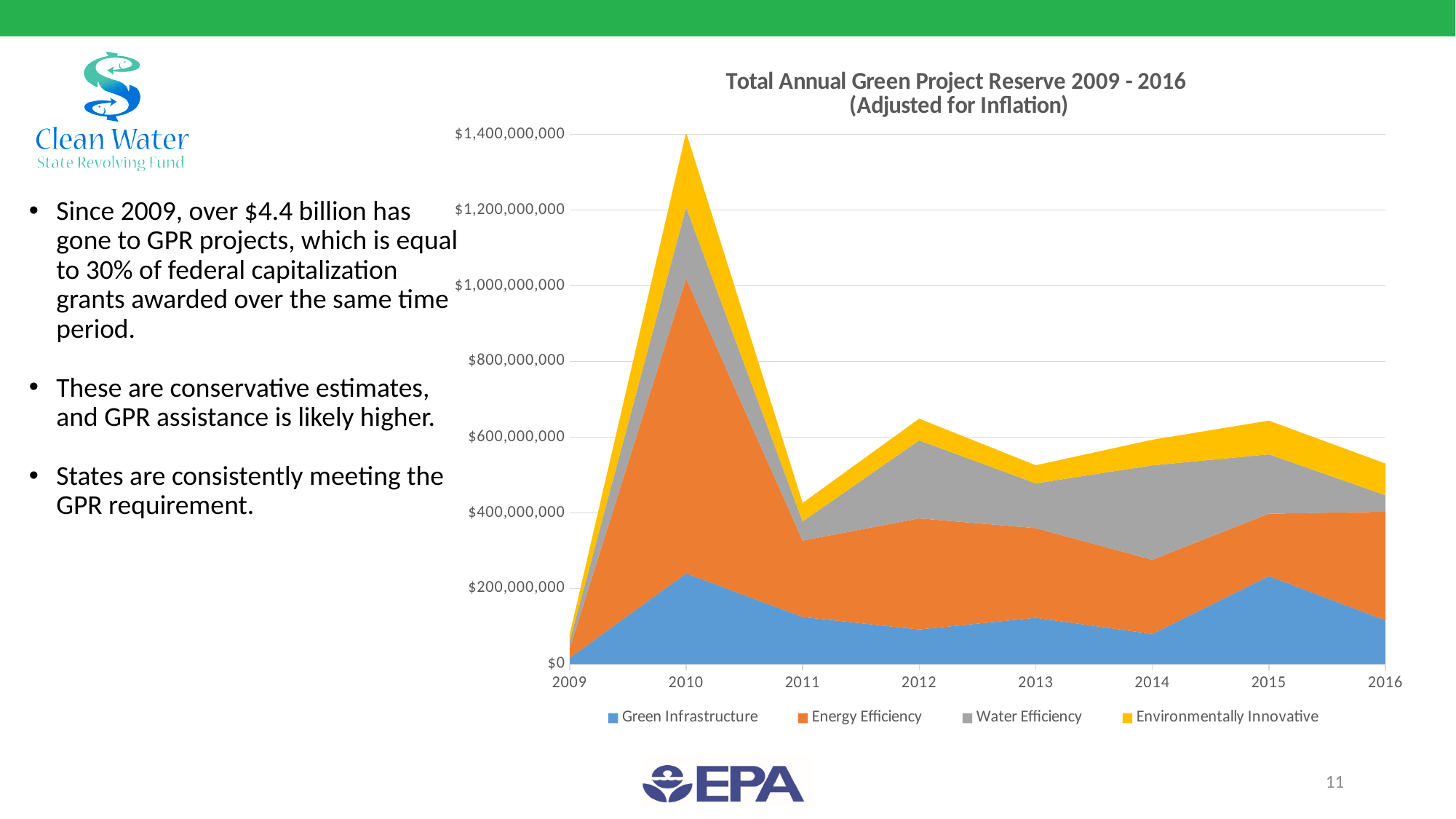
In which year is the total annual Green Project Reserve highest? 2010 How many series does the chart's legend list? 4 Is the total value for 2011 greater or less than $600,000,000? less In which year is the total annual Green Project Reserve lowest? 2009 Does the total value rise or fall from 2010 to 2011? Fall Which year has the larger total, 2010 or 2012? 2010 Which series is shown in yellow in the chart's legend? Environmentally Innovative What is the title of the chart? Total Annual Green Project Reserve 2009 - 2016 (Adjusted for Inflation) Is the total value for 2010 greater or less than $1,200,000,000? greater What kind of chart is shown on the slide? Stacked area chart How many years are plotted along the x axis of the chart? 8 Is the total value for 2009 greater or less than $200,000,000? less